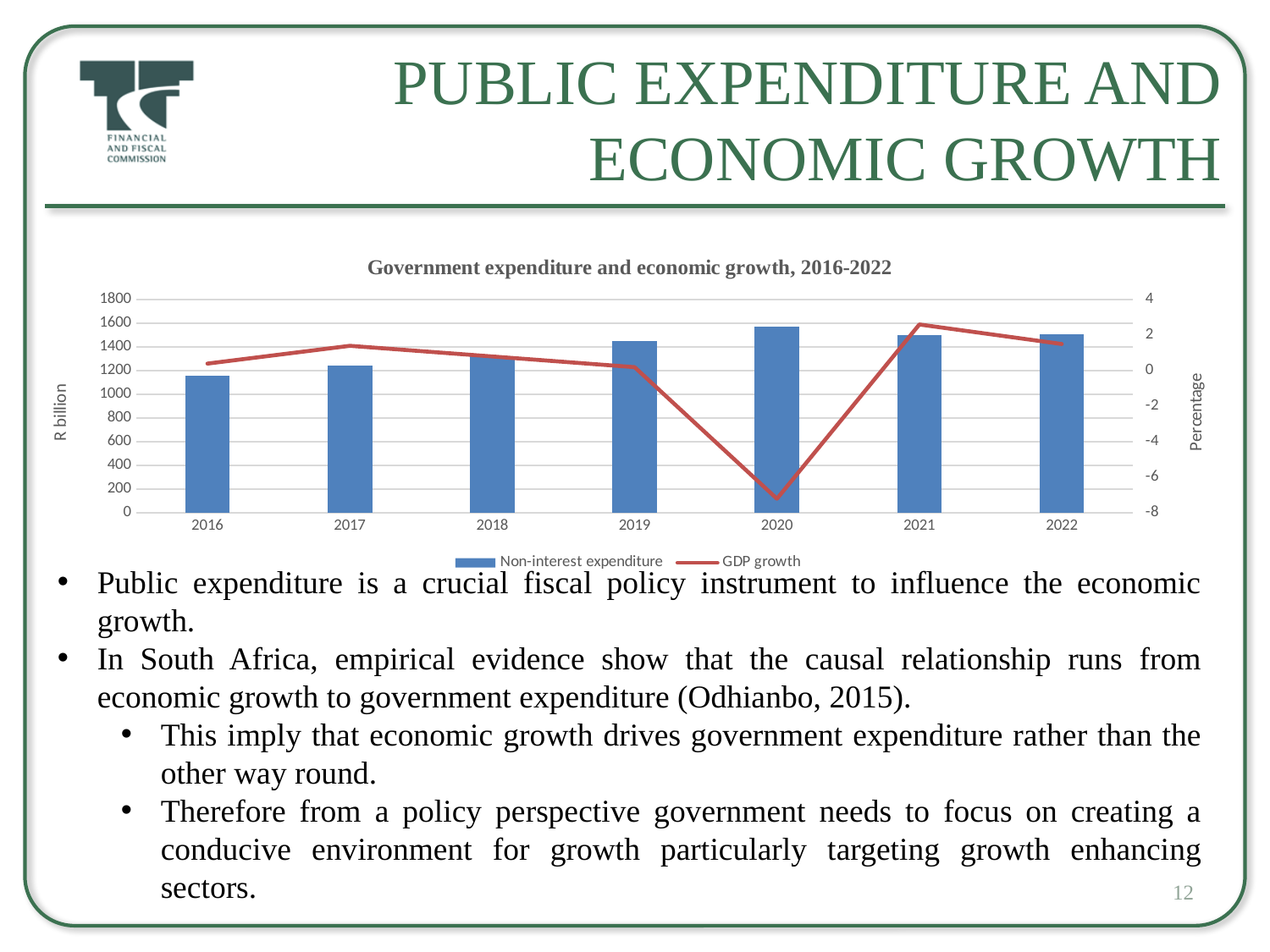
Is the GDP growth for 2020 greater or less than -6 percent? less How many years are shown on the x axis of the chart? 7 What type of chart is shown on the slide? Combined bar and line chart In which year is GDP growth at its lowest? 2020 What is the title of the chart? Government expenditure and economic growth, 2016-2022 Is the non-interest expenditure for 2020 greater or less than 1400 R billion? greater Which year has the larger non-interest expenditure bar, 2017 or 2019? 2019 How many series does the chart legend list? 2 Do the non-interest expenditure bars rise or fall from 2016 to 2020? rise In which year is GDP growth at its highest? 2021 Which year has the highest non-interest expenditure bar? 2020 Which year has the lowest non-interest expenditure bar? 2016